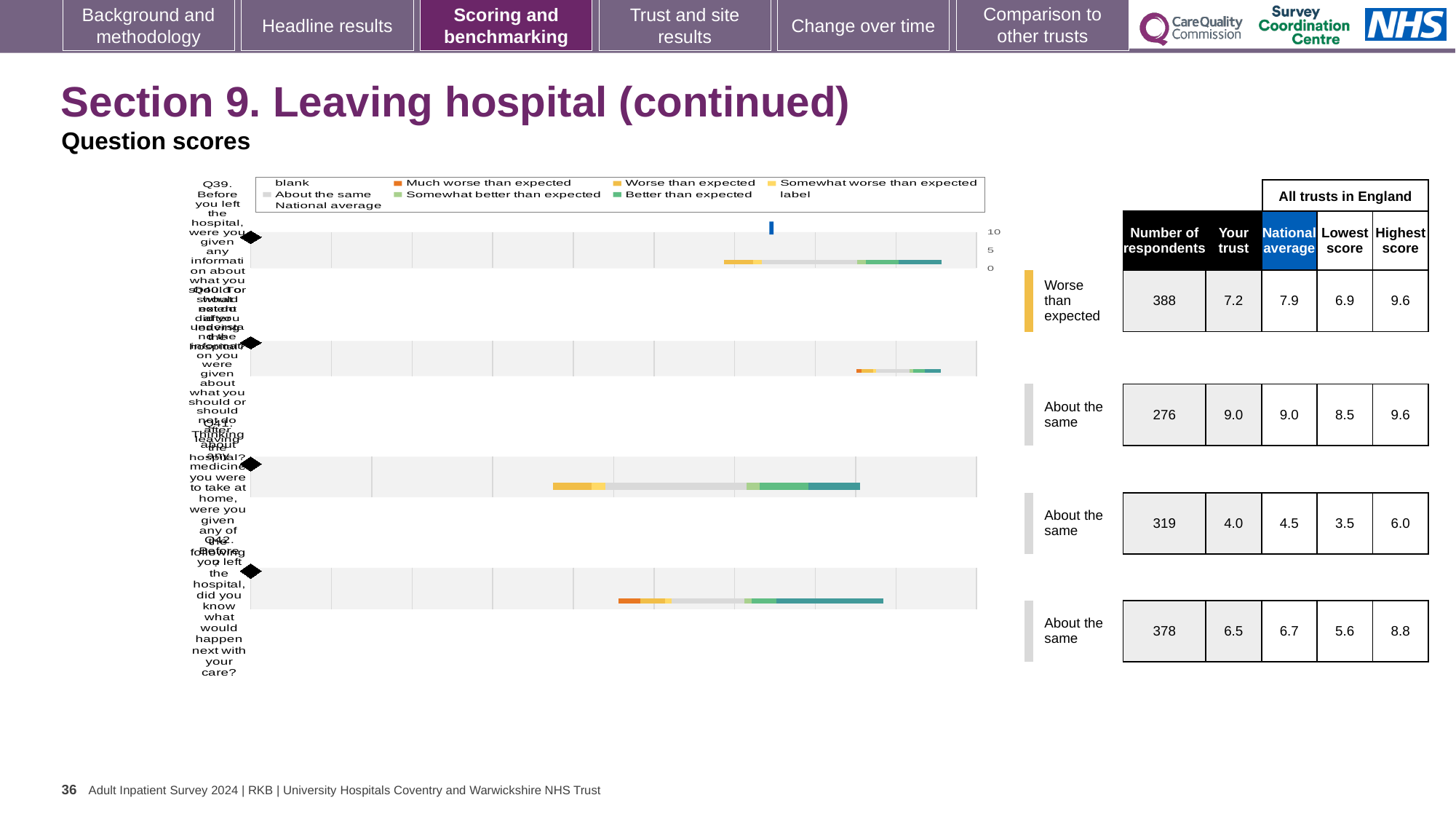
For the top chart (Q39), what is the 'Your trust' score shown in the table? 7.2 How many question charts (rows) are shown on the slide? 4 For the third chart from the top, what is the 'Your trust' score? 4.0 For the top chart (Q39), what is the difference between the national average and the trust's score? 0.7 What kind of chart is used to show the question scores on this slide? bar chart For the top chart (Q39), which is larger: the trust's score or the national average? National average How many of the four charts are labelled 'About the same'? 3 For the top chart (Q39), what is the national average score? 7.9 What benchmark label is shown beside the top chart (Q39)? Worse than expected For the bottom chart (Q42), what is the highest score among all trusts in England? 8.8 For the bottom chart (Q42), how many respondents are listed? 378 For the second chart from the top, what is the lowest score among all trusts in England? 8.5